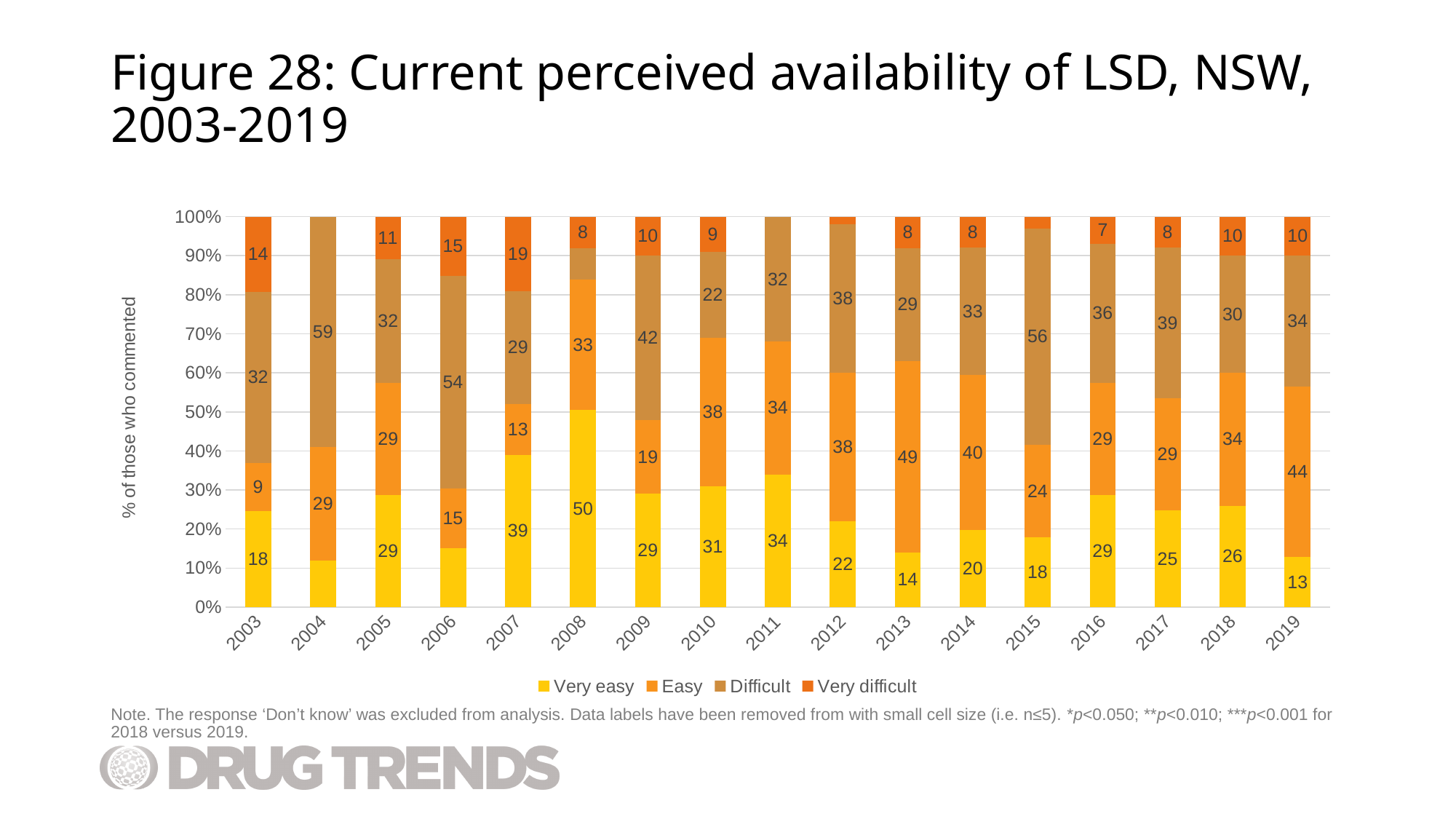
What is the 'Very difficult' value for 2007? 19 How many series does the legend list? 4 In which year is the 'Very easy' share highest? 2008 What is the difference between the 'Easy' values for 2019 and 2018? 10 What kind of chart is shown on the slide? Stacked bar chart What percentage of respondents rated LSD as 'Very easy' to obtain in 2008? 50 Which year has the larger 'Very easy' value, 2007 or 2013? 2007 How many years are shown on the x axis? 17 Is the 'Very easy' value for 2004 greater or less than 20%? less In which year is the 'Easy' share highest? 2013 What is the 'Difficult' value for 2004? 59 What is the 'Easy' value for 2019? 44